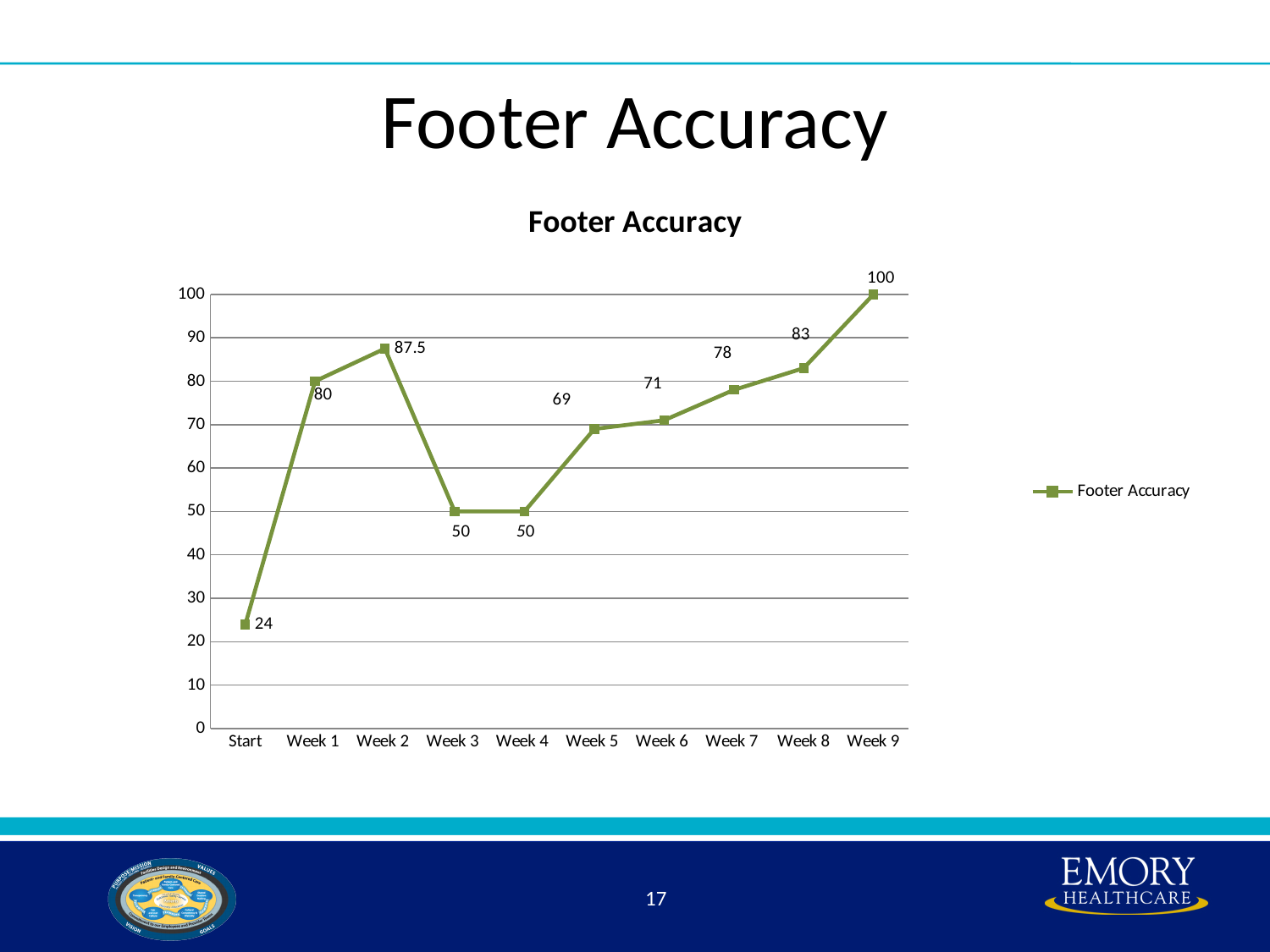
What is the Footer Accuracy value at Week 2? 87.5 What kind of chart is shown on the slide? Line chart How many series does the legend list? 1 What is the difference between the Footer Accuracy values at Week 9 and Start? 76 How many data points are plotted on the chart? 10 What is the Footer Accuracy value at Week 5? 69 Which is larger, the Footer Accuracy value at Week 1 or at Week 7? Week 1 What is the difference between the Footer Accuracy values at Week 2 and Week 3? 37.5 Which point has the highest Footer Accuracy value? Week 9 Do the Footer Accuracy values rise or fall from Week 4 to Week 9? Rise What is the Footer Accuracy value at Start? 24 Which point has the lowest Footer Accuracy value? Start